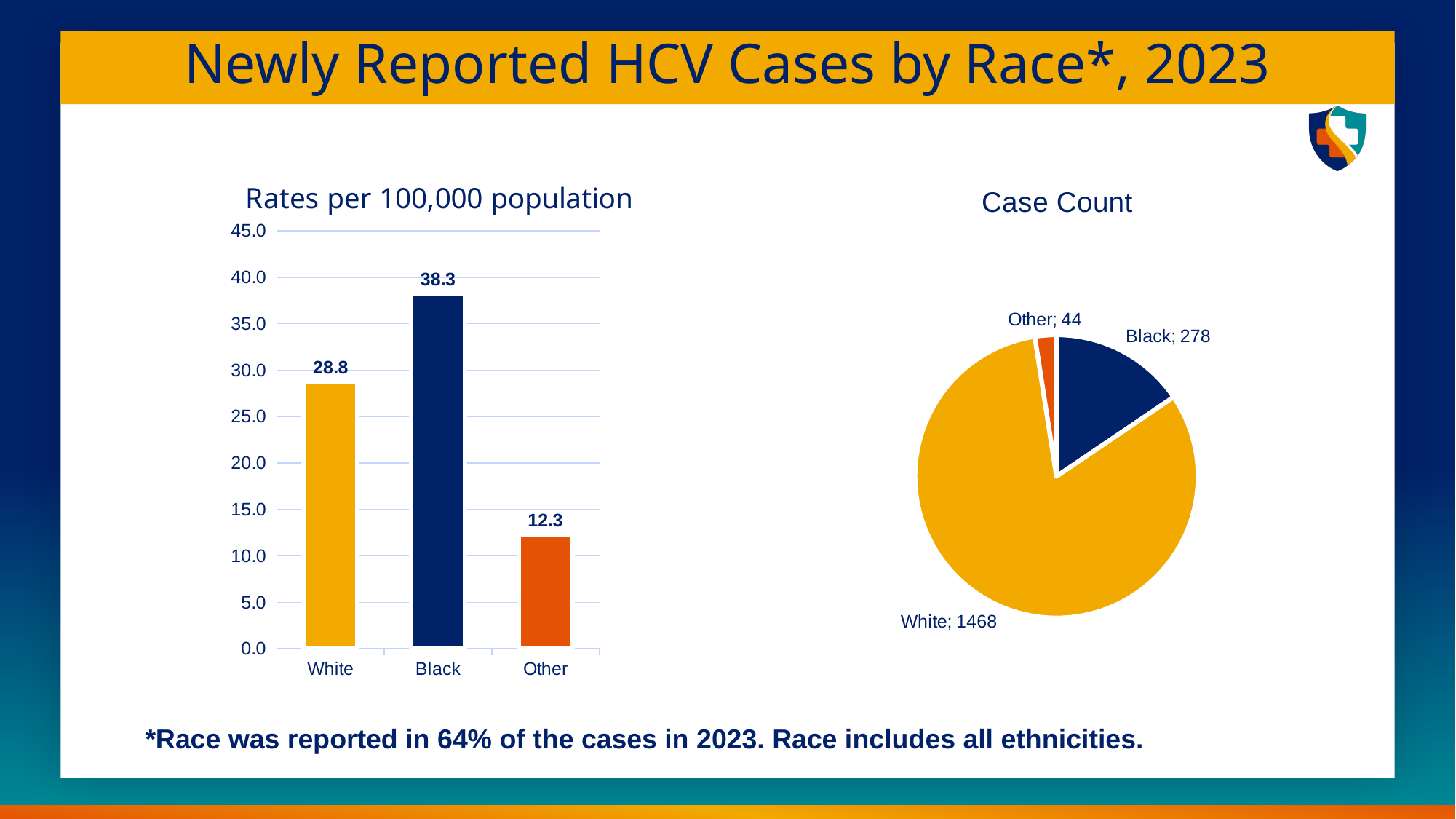
In the 'Rates per 100,000 population' chart, is the rate for Other greater or less than 15.0? less In the 'Rates per 100,000 population' chart, what is the rate for Black? 38.3 In the 'Rates per 100,000 population' chart, what is the difference between the rates for Black and White? 9.5 What kind of chart is the 'Rates per 100,000 population' chart? bar chart In the 'Case Count' chart, which race has the largest slice? White In the 'Case Count' chart, how many cases are reported for Black? 278 In the 'Rates per 100,000 population' chart, what is the rate for White? 28.8 In the 'Rates per 100,000 population' chart, which race has the highest rate? Black In the 'Case Count' chart, what is the total number of cases across all three slices? 1790 In the 'Rates per 100,000 population' chart, how many race categories are shown? 3 In the 'Case Count' chart, how many cases are reported for Other? 44 In the 'Rates per 100,000 population' chart, which race has the lowest rate? Other